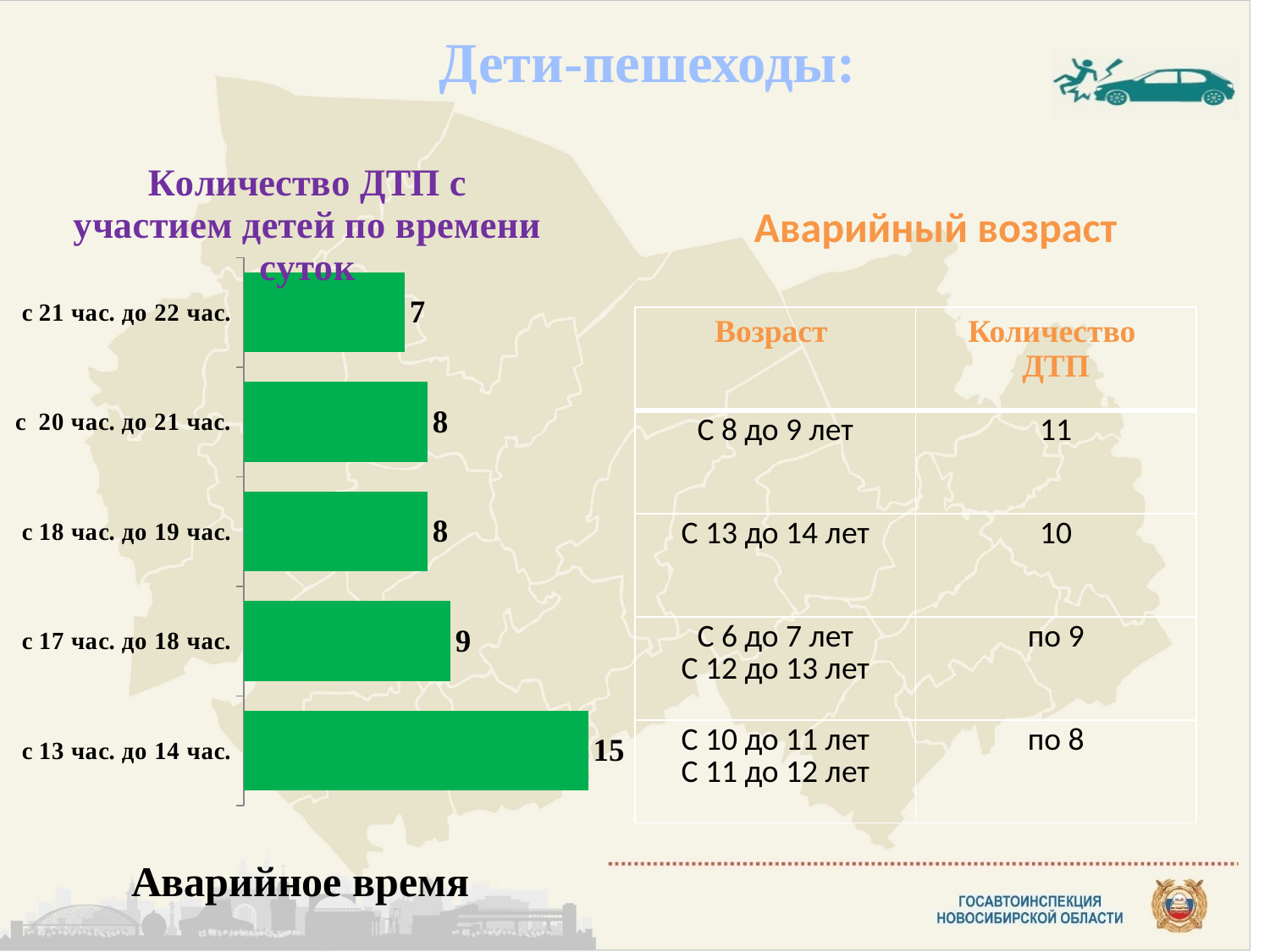
What is the value for the category 'с 21 час. до 22 час.'? 7 Which time period has the lowest number of accidents? с 21 час. до 22 час. What is the value for the category 'с 18 час. до 19 час.'? 8 What is the title of the bar chart? Количество ДТП с участием детей по времени суток What is the value for the category 'с 17 час. до 18 час.'? 9 What colour are the bars in the chart? Green What is the difference between the values for 'с 13 час. до 14 час.' and 'с 17 час. до 18 час.'? 6 How many time-period categories are shown in the bar chart? 5 What type of chart is used to show the number of accidents by time of day? Bar chart What is the value for the category 'с 13 час. до 14 час.'? 15 Which time period has the highest number of accidents? с 13 час. до 14 час. Which is larger: the value for 'с 20 час. до 21 час.' or the value for 'с 21 час. до 22 час.'? с 20 час. до 21 час.